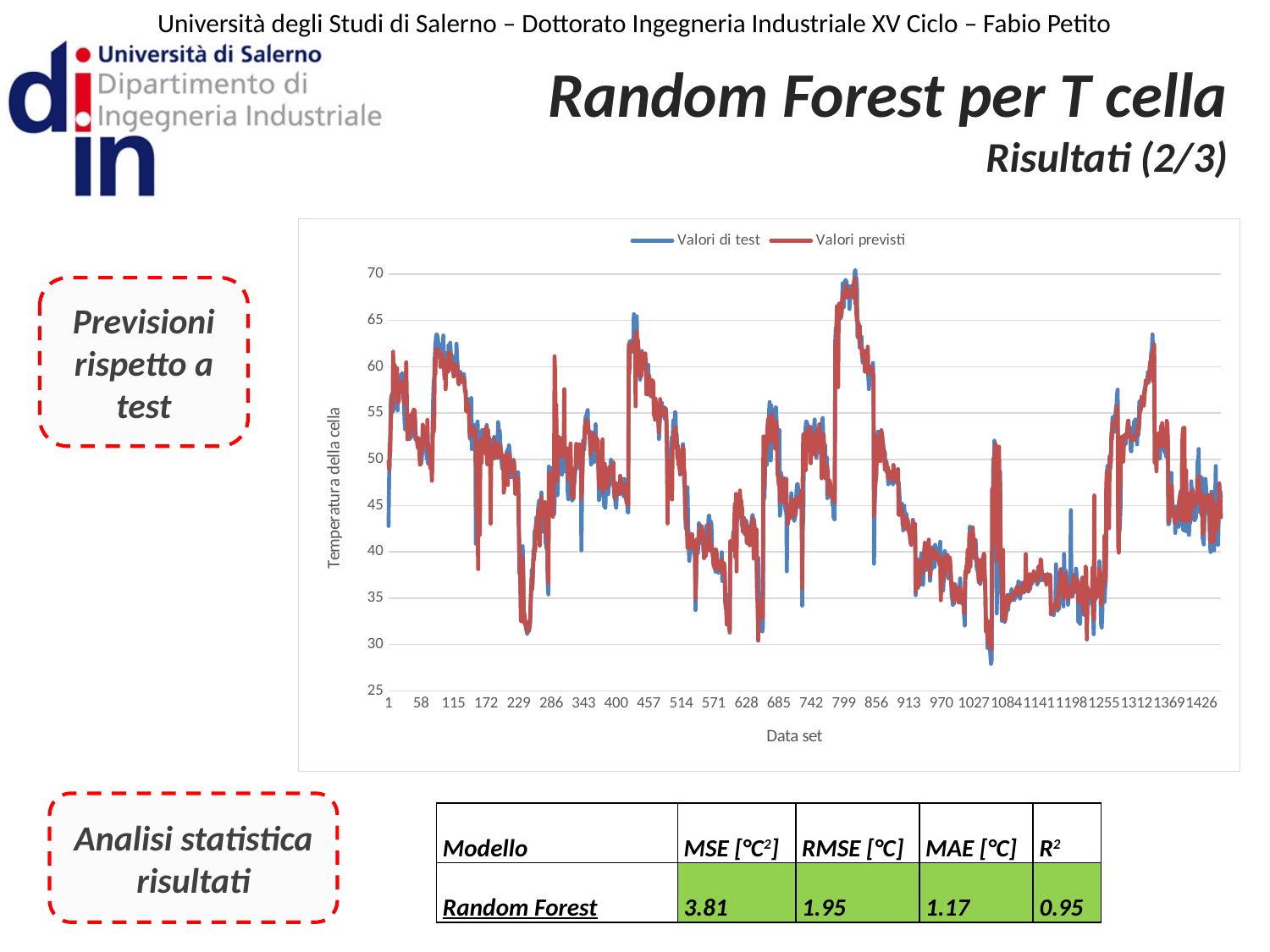
Is the value of the series around data set 1141 greater or less than 40? less What are the two series named in the chart's legend? Valori di test, Valori previsti Is the peak value of the series around data set 799 greater or less than 65? greater How many series does the chart's legend list? 2 What kind of chart is shown on the slide? line chart What is the title of the vertical axis of the chart? Temperatura della cella Do the values of the series rise or fall between data set 799 and data set 913? fall What is the largest tick label shown on the x axis of the chart? 1426 Is the lowest value of the series around data set 1084 greater or less than 30? less